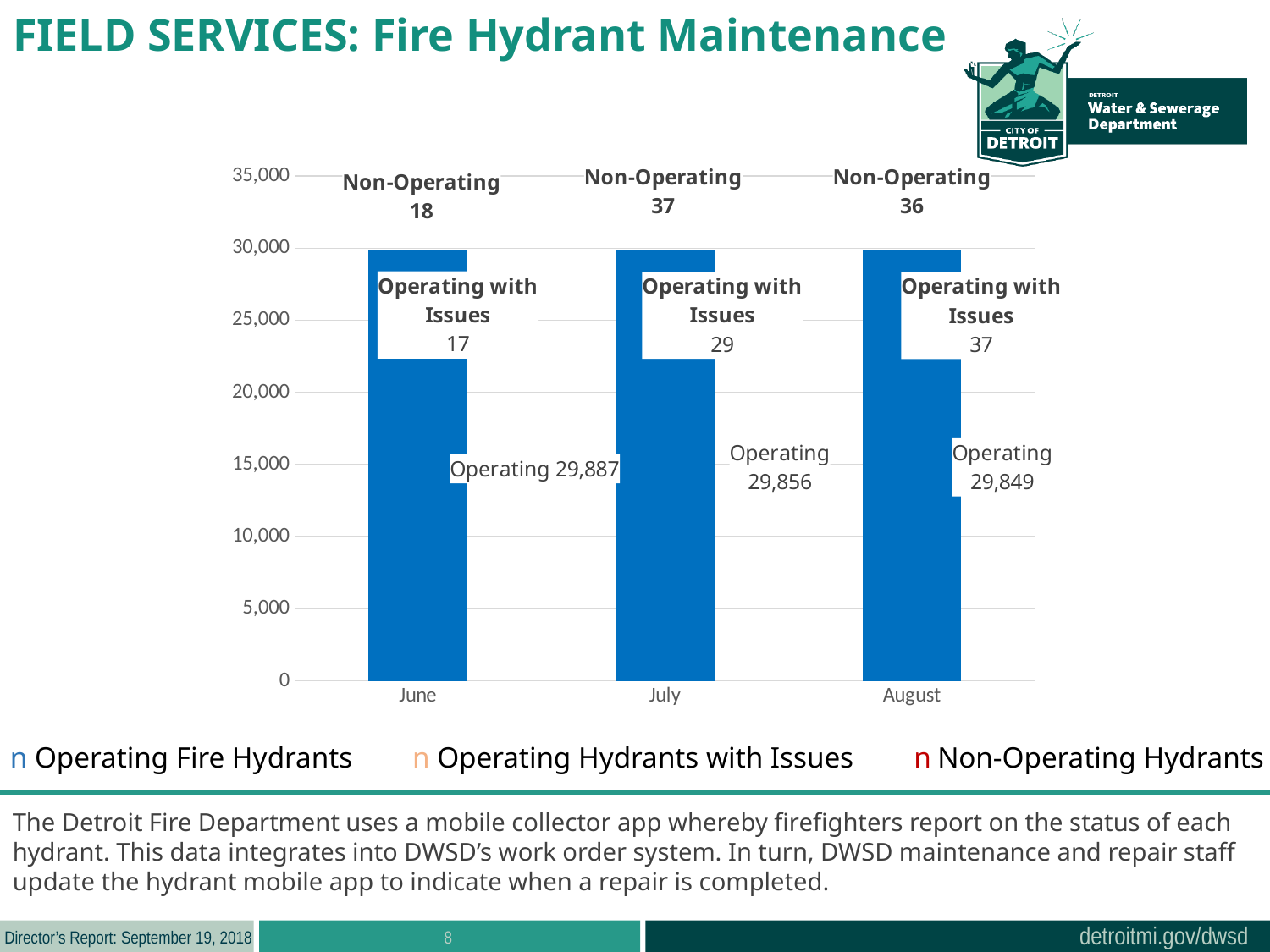
What is the number of Operating fire hydrants in June? 29,887 How many months are shown on the x axis? 3 By how much does the Non-Operating count in July exceed that in June? 19 Which is larger, the Operating with Issues value for July or for August? August Which month has the highest number of Operating fire hydrants? June How many series does the legend list? 3 How many Non-Operating hydrants are shown for July? 37 What is the value for Operating with Issues in August? 37 Which month has the lowest number of Operating Hydrants with Issues? June What is the difference between the Operating hydrant counts for June and August? 38 What kind of chart is shown on the slide? Stacked bar chart What is the total of the stacked bar for June? 29,922